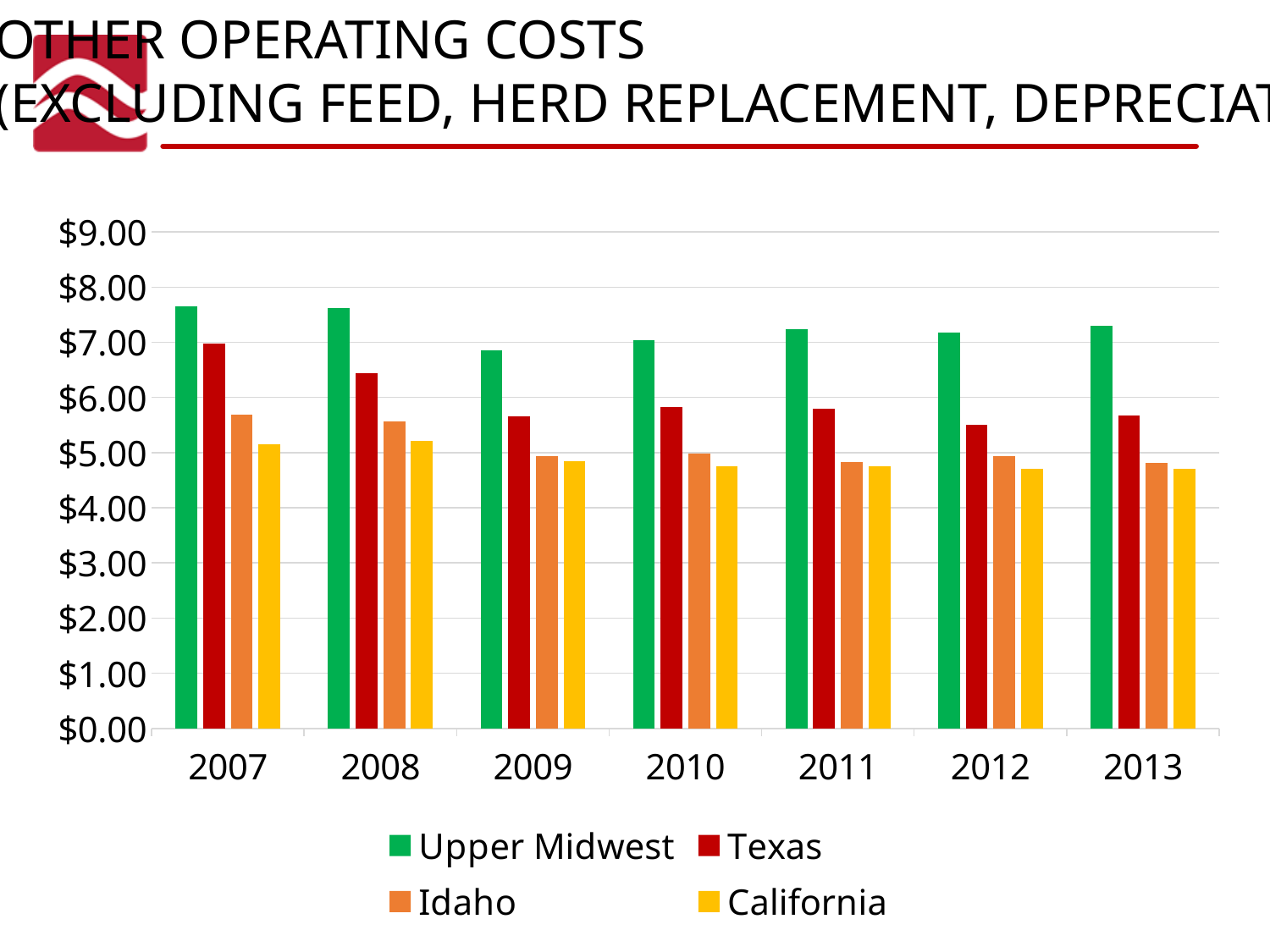
How many years are shown on the x axis? 7 What kind of chart is shown on the slide? bar chart What colour represents Upper Midwest in the legend? green Which region has the highest other operating costs in 2007? Upper Midwest Which is larger, the Texas value in 2007 or the Texas value in 2013? 2007 How many series does the legend list? 4 Is the value for Texas in 2012 greater or less than $6.00? less Do the Texas values rise or fall from 2007 to 2009? fall Which region has the lowest other operating costs in 2007? California Is the value for Idaho in 2007 greater or less than $5.00? greater In which year is the Texas value highest? 2007 Is the value for Upper Midwest in 2007 greater or less than $7.00? greater